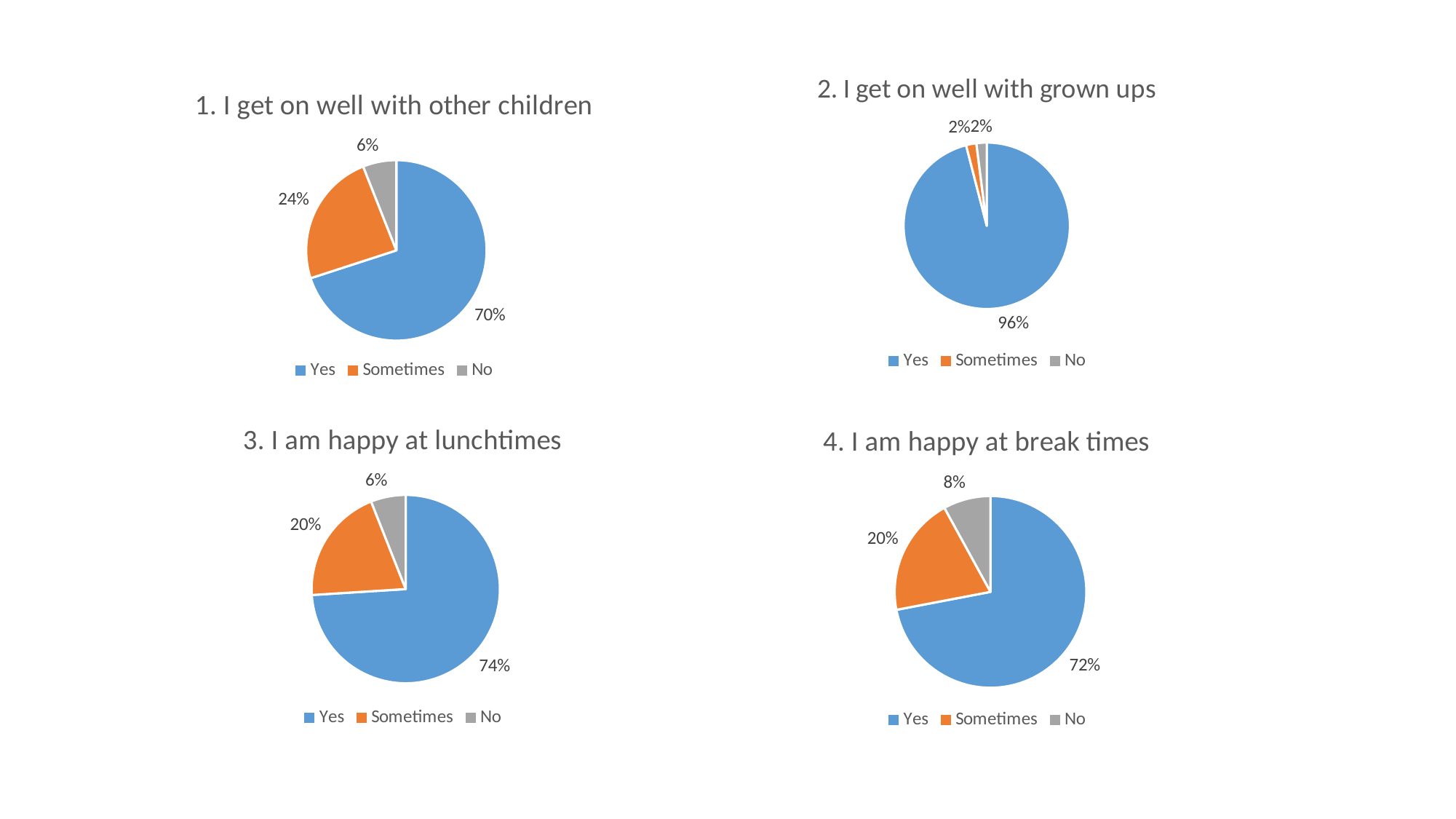
In the chart '3. I am happy at lunchtimes', what percentage answered No? 6% In the chart '1. I get on well with other children', what percentage answered Yes? 70% In the chart '1. I get on well with other children', what percentage answered Sometimes? 24% In the chart '4. I am happy at break times', is the share for Sometimes larger or smaller than the share for No? larger In the chart '4. I am happy at break times', what percentage answered Sometimes? 20% In the chart '4. I am happy at break times', which response has the largest share? Yes How many pie charts are shown on the slide? 4 In the chart '2. I get on well with grown ups', what percentage answered Yes? 96% How many entries does the legend of the chart '3. I am happy at lunchtimes' list? 3 In the chart '3. I am happy at lunchtimes', what is the difference between the Yes and Sometimes percentages? 54% What type of chart is '2. I get on well with grown ups'? pie chart In the chart '1. I get on well with other children', which response has the smallest share? No